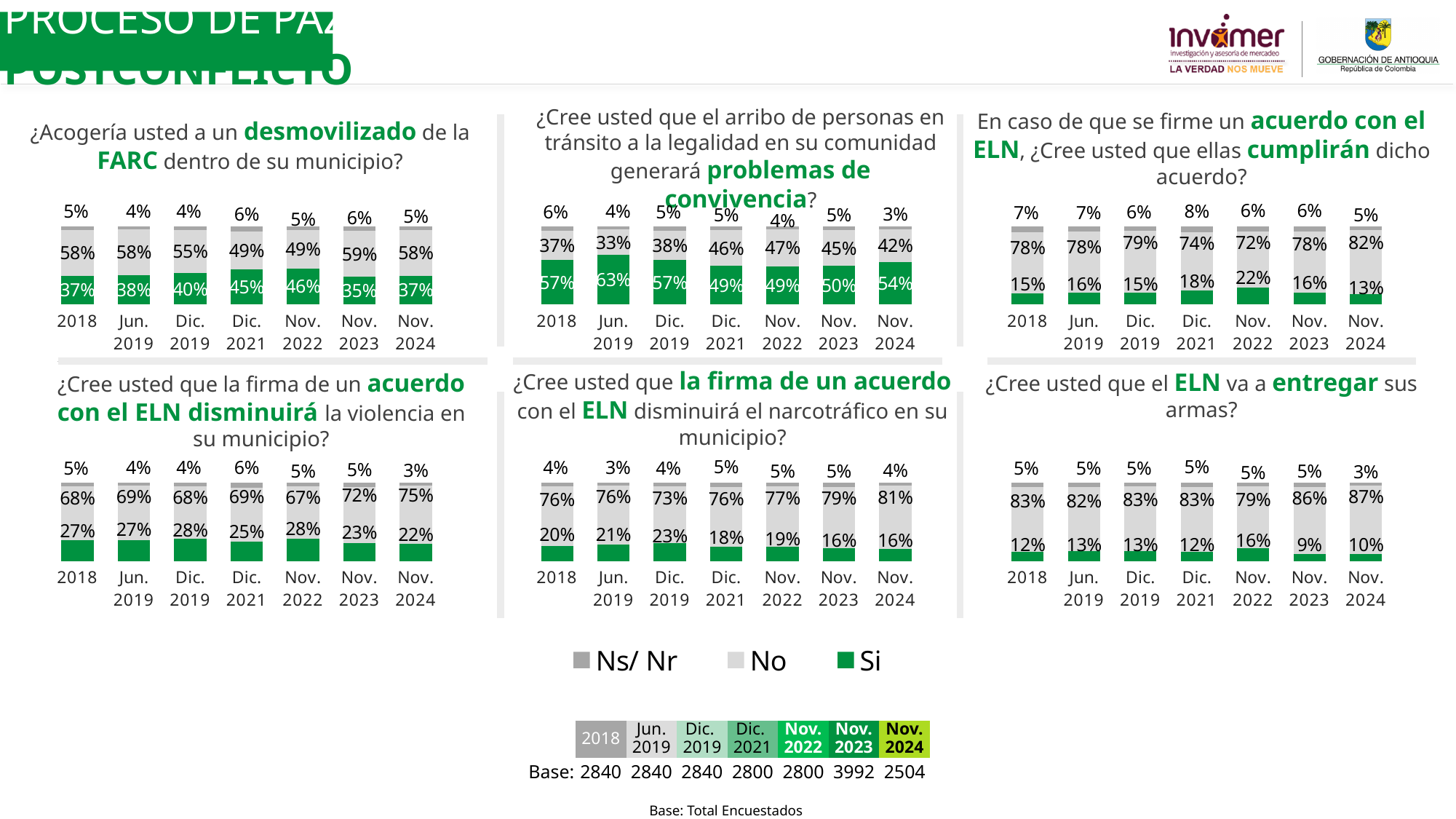
How many time periods are plotted in each chart on this slide? 7 In the bottom-right chart about the ELN handing over its weapons, what percentage answered 'Si' in Nov. 2023? 9% In the bottom-left chart about an ELN agreement reducing violence, what percentage answered 'Si' in Nov. 2024? 22% In the top-right chart about whether the ELN will comply with an agreement, which period has the highest 'Si' percentage? Nov. 2022 How many series does the shared legend list for the charts on this slide? 3 In the bottom-middle chart about an ELN agreement reducing drug trafficking, is the 'No' percentage larger in Nov. 2024 or in Dic. 2019? Nov. 2024 In the bottom-right chart about the ELN handing over its weapons, what is the total of the Nov. 2024 bar (Ns/Nr + No + Si)? 100% In the top-middle chart about 'problemas de convivencia', what percentage answered 'No' in Jun. 2019? 33% In the top-middle chart about 'problemas de convivencia', which period has the lowest 'Si' percentage? Dic. 2021 and Nov. 2022 (49%) In the top-left chart about welcoming a demobilized FARC member, what percentage answered 'Si' in Nov. 2022? 46% In the top-right chart about whether the ELN will comply with an agreement, what is the difference between the 'No' percentage in Nov. 2024 and in 2018? 4% In the top-left chart about welcoming a demobilized FARC member, which period has the highest 'Si' percentage? Nov. 2022